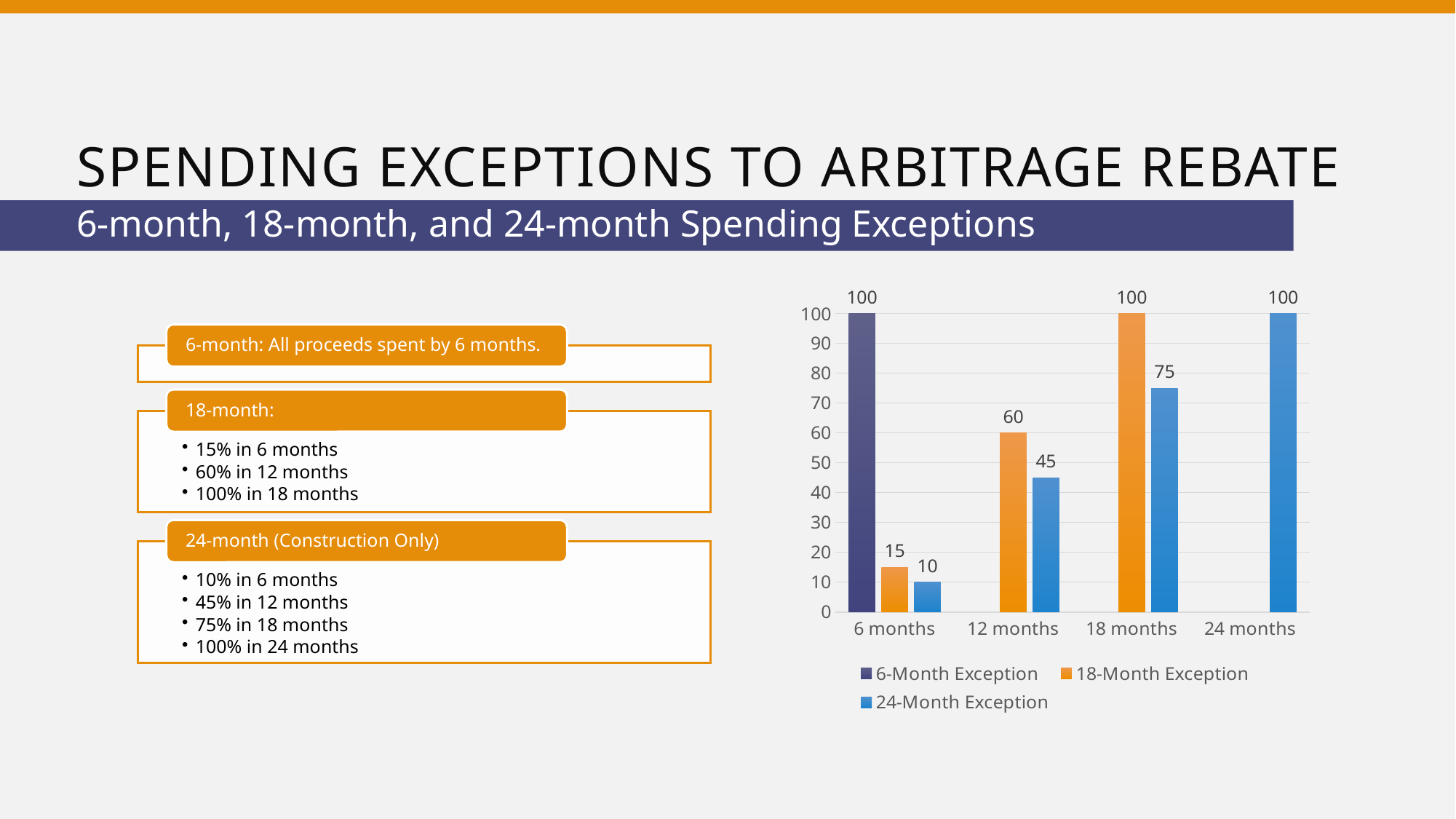
What is the difference between the 18-Month Exception and the 24-Month Exception values at 12 months? 15 What is the value for the 24-Month Exception at 18 months? 75 What is the value for the 18-Month Exception at 12 months? 60 What is the value for the 24-Month Exception at 6 months? 10 What is the value for the 18-Month Exception at 6 months? 15 How many categories are shown on the x axis? 4 What kind of chart is shown on the slide? Bar chart Which series is shown in dark blue/purple in the legend? 6-Month Exception Do the values for the 24-Month Exception series rise or fall from 6 months to 24 months? Rise At 18 months, which series has the larger value: the 18-Month Exception or the 24-Month Exception? 18-Month Exception How many series does the legend list? 3 At which x-axis category does the 24-Month Exception series reach its lowest value? 6 months